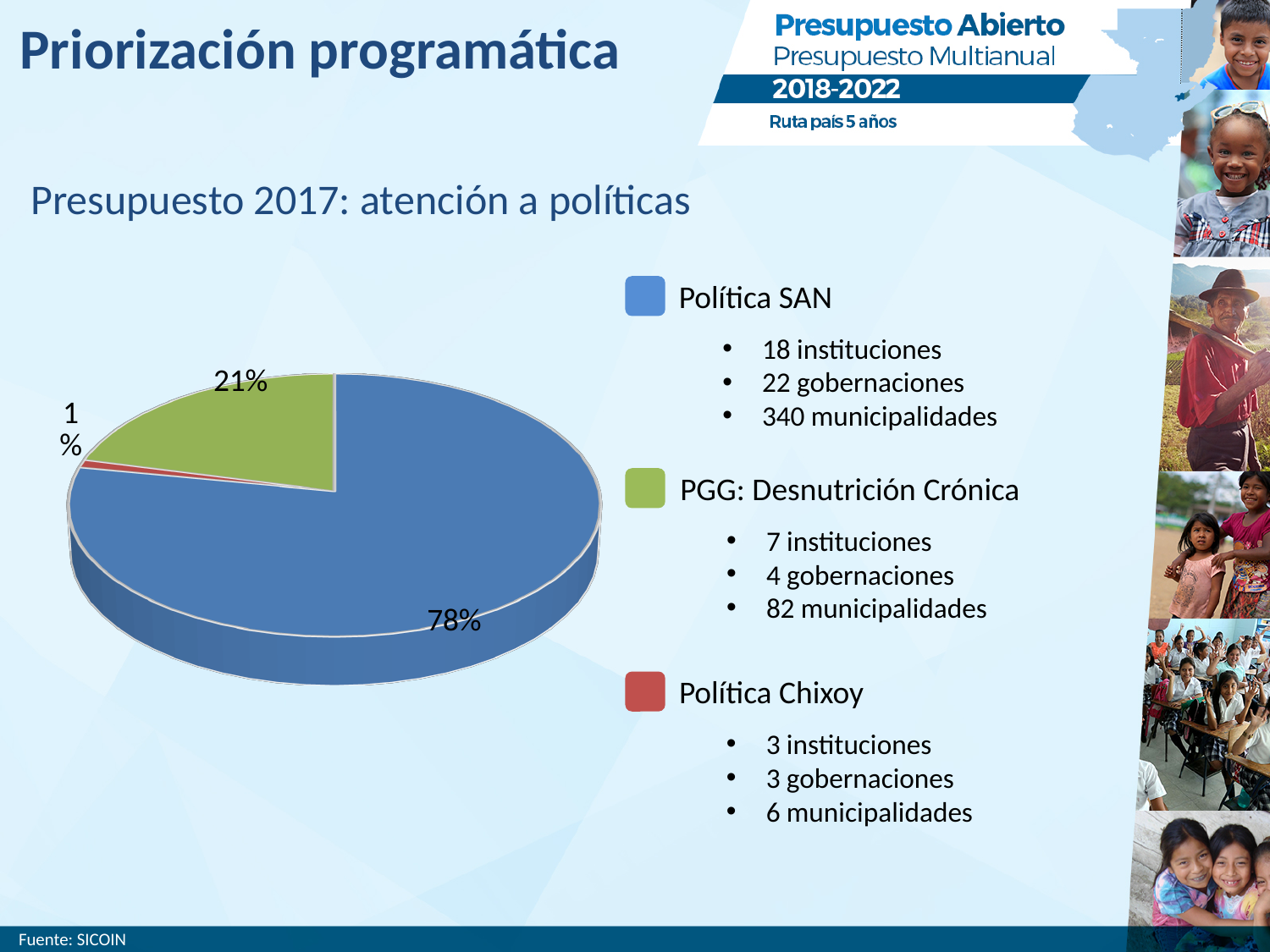
What colour is the slice for Política SAN? blue What share of the pie does Política SAN represent? 78% Which policy has the largest slice of the pie? Política SAN What is the difference in percentage points between the Política SAN slice and the PGG: Desnutrición Crónica slice? 57 Which is larger, the slice for PGG: Desnutrición Crónica or the slice for Política Chixoy? PGG: Desnutrición Crónica What is the combined share of the PGG: Desnutrición Crónica and Política Chixoy slices? 22% What kind of chart is shown on the slide? pie chart How many slices does the pie chart have? 3 What share of the pie does Política Chixoy represent? 1% What share of the pie does PGG: Desnutrición Crónica represent? 21% Which policy has the smallest slice of the pie? Política Chixoy What colour is the slice for PGG: Desnutrición Crónica? green